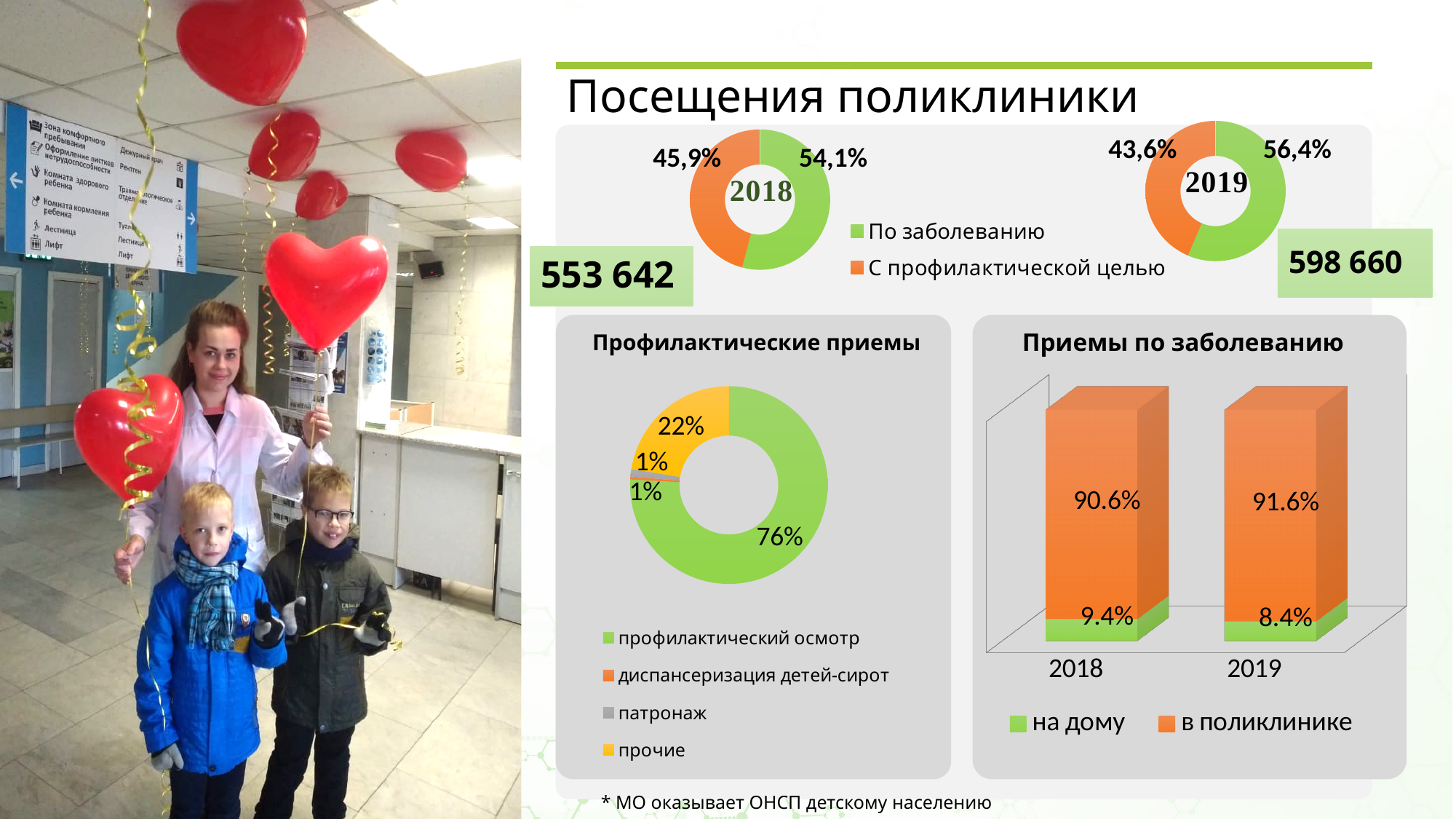
In the 2018 donut chart at the top, what share of visits is labelled 'С профилактической целью'? 45,9% In the 'Приемы по заболеванию' chart, what is the value for 'на дому' in 2018? 9.4% What kind of chart is 'Приемы по заболеванию'? Stacked bar chart In the 2018 donut chart at the top, what share of visits is labelled 'По заболеванию'? 54,1% In the 'Профилактические приемы' chart, what share is 'профилактический осмотр'? 76% In the 'Профилактические приемы' chart, what share is 'патронаж'? 1% In the 2019 donut chart at the top, what share of visits is labelled 'По заболеванию'? 56,4% In the 2019 donut chart at the top, what share of visits is labelled 'С профилактической целью'? 43,6% In the 2019 donut chart at the top, which category has the larger share, 'По заболеванию' or 'С профилактической целью'? По заболеванию In the 'Профилактические приемы' chart, what share is 'прочие'? 22% In the 'Приемы по заболеванию' chart, what is the value for 'в поликлинике' in 2019? 91.6% How many categories does the legend of the 'Профилактические приемы' chart list? 4